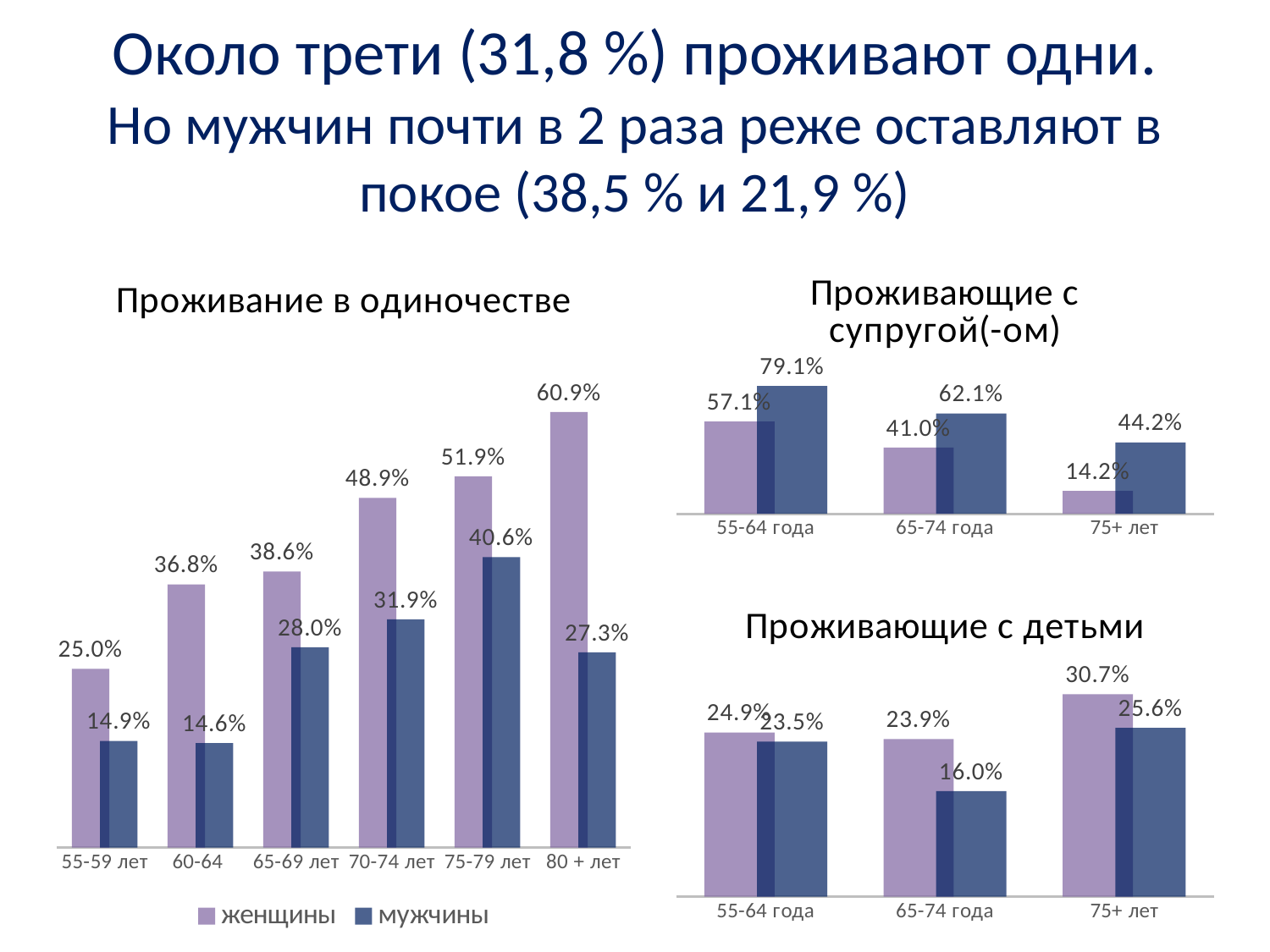
In the chart 'Проживание в одиночестве', which age category has the lowest value for мужчины? 60-64 How many series does the legend of the chart 'Проживание в одиночестве' list? 2 In the chart 'Проживающие с детьми', what is the value of the light purple bar for 75+ лет? 30.7% In the chart 'Проживающие с супругой(-ом)', what is the value of the dark blue bar for 55-64 года? 79.1% In the chart 'Проживающие с детьми', which is larger for 65-74 года: the light purple bar (23.9%) or the dark blue bar (16.0%)? the light purple bar (23.9%) In the chart 'Проживание в одиночестве', what is the difference between the женщины and мужчины values for 80 + лет? 33.6% In the chart 'Проживание в одиночестве', which age category has the highest value for мужчины? 75-79 лет In the chart 'Проживание в одиночестве', do the женщины values rise or fall as age increases along the x axis? rise In the chart 'Проживание в одиночестве', what is the value for женщины in the 80 + лет category? 60.9% What type of chart is 'Проживающие с супругой(-ом)'? bar chart In the chart 'Проживание в одиночестве', what is the value for мужчины in the 65-69 лет category? 28.0% How many age categories are shown in the chart 'Проживание в одиночестве'? 6